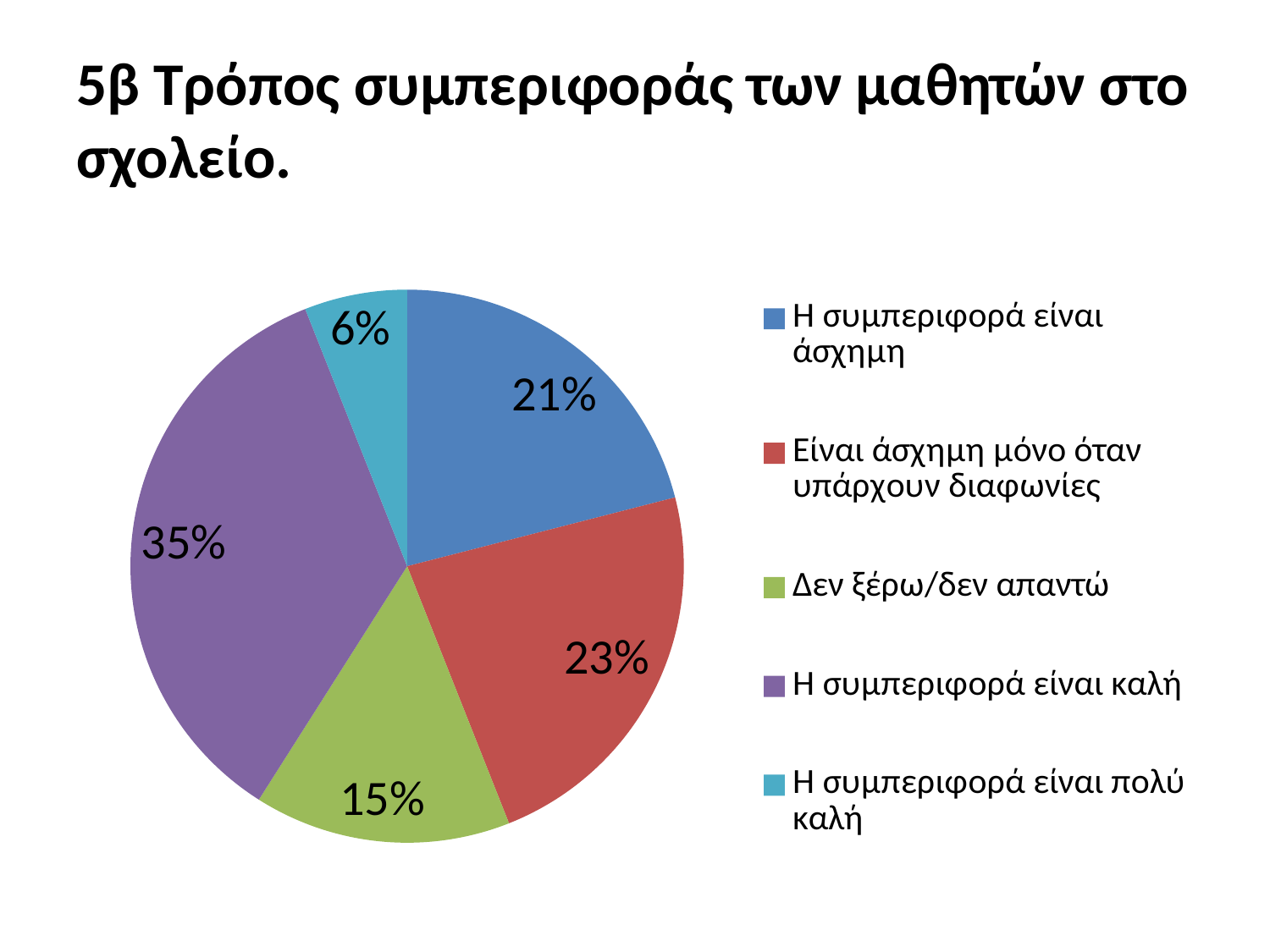
How many categories does the pie chart have? 5 Which is larger: the slice for "Η συμπεριφορά είναι άσχημη" or the slice for "Δεν ξέρω/δεν απαντώ"? Η συμπεριφορά είναι άσχημη Which category has the largest slice of the pie? Η συμπεριφορά είναι καλή What percentage of the pie corresponds to "Η συμπεριφορά είναι καλή"? 35% What percentage is shown for "Είναι άσχημη μόνο όταν υπάρχουν διαφωνίες"? 23% What is the difference in percentage points between "Η συμπεριφορά είναι καλή" and "Η συμπεριφορά είναι πολύ καλή"? 29 What percentage is shown for "Η συμπεριφορά είναι πολύ καλή"? 6% What percentage is shown for "Η συμπεριφορά είναι άσχημη"? 21% What type of chart is shown on the slide? Pie chart Which category has the smallest slice of the pie? Η συμπεριφορά είναι πολύ καλή What percentage is shown for "Δεν ξέρω/δεν απαντώ"? 15% What colour is the slice for "Δεν ξέρω/δεν απαντώ"? Green